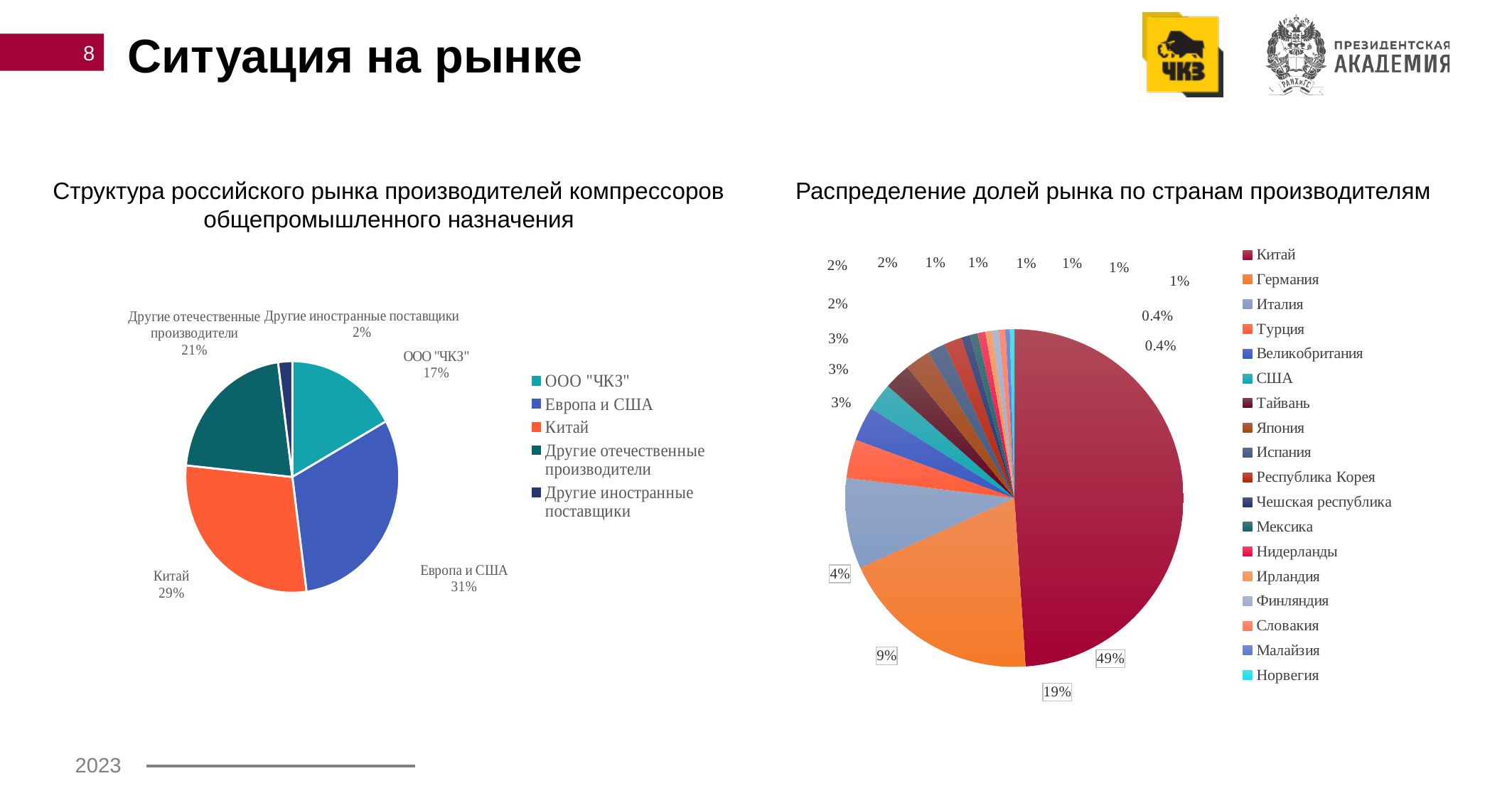
On the left chart, which is larger: the share of Китай or the share of Другие отечественные производители? Китай How many categories does the left chart's legend list? 5 On the left chart (Структура российского рынка производителей компрессоров общепромышленного назначения), what share does Европа и США hold? 31% On the left chart, which category has the smallest share? Другие иностранные поставщики On the left chart, what is the difference between the shares of Китай and ООО "ЧКЗ"? 12% On the left chart, which category has the largest share? Европа и США How many countries does the right chart's legend list? 18 What type of chart is the left chart? Pie chart On the right chart, what is the difference between the shares of Китай and Германия? 30% On the right chart, which country has the largest market share? Китай On the left chart, what is the share of ООО "ЧКЗ"? 17% On the right chart (Распределение долей рынка по странам производителям), what share does Китай hold? 49%